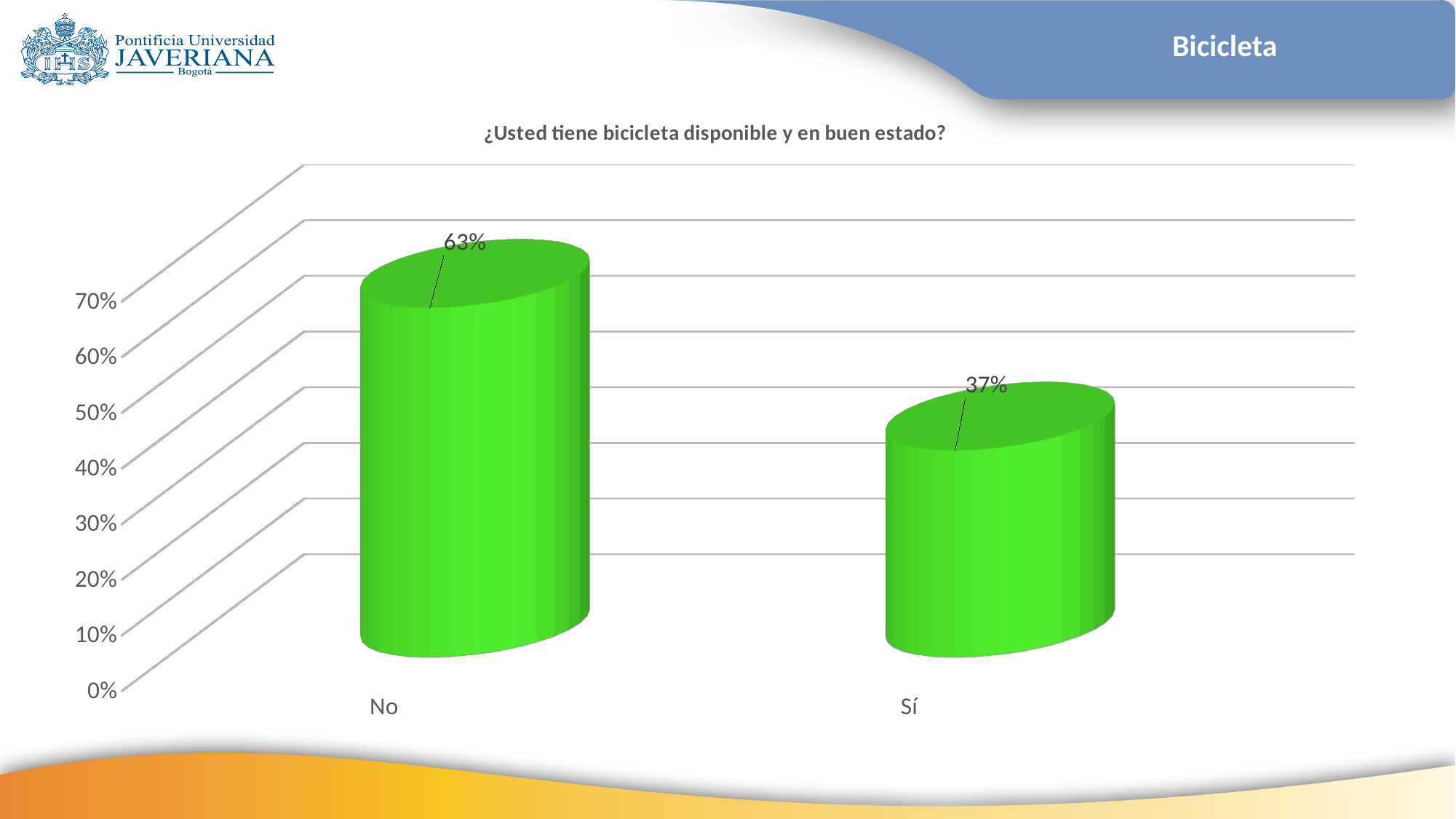
Is the value for "No" greater or less than 60%? greater Which category has the lowest value? Sí What is the difference between the values for "No" and "Sí"? 26% Is the value for "Sí" greater or less than 40%? less How many categories are shown on the x axis? 2 What is the value for "Sí"? 37% Which is larger, the value for "No" or the value for "Sí"? No What is the title of the chart? ¿Usted tiene bicicleta disponible y en buen estado? What kind of chart is shown on the slide? bar chart What is the highest value labelled on the vertical axis? 70% What is the value for "No"? 63% Which category has the highest value? No